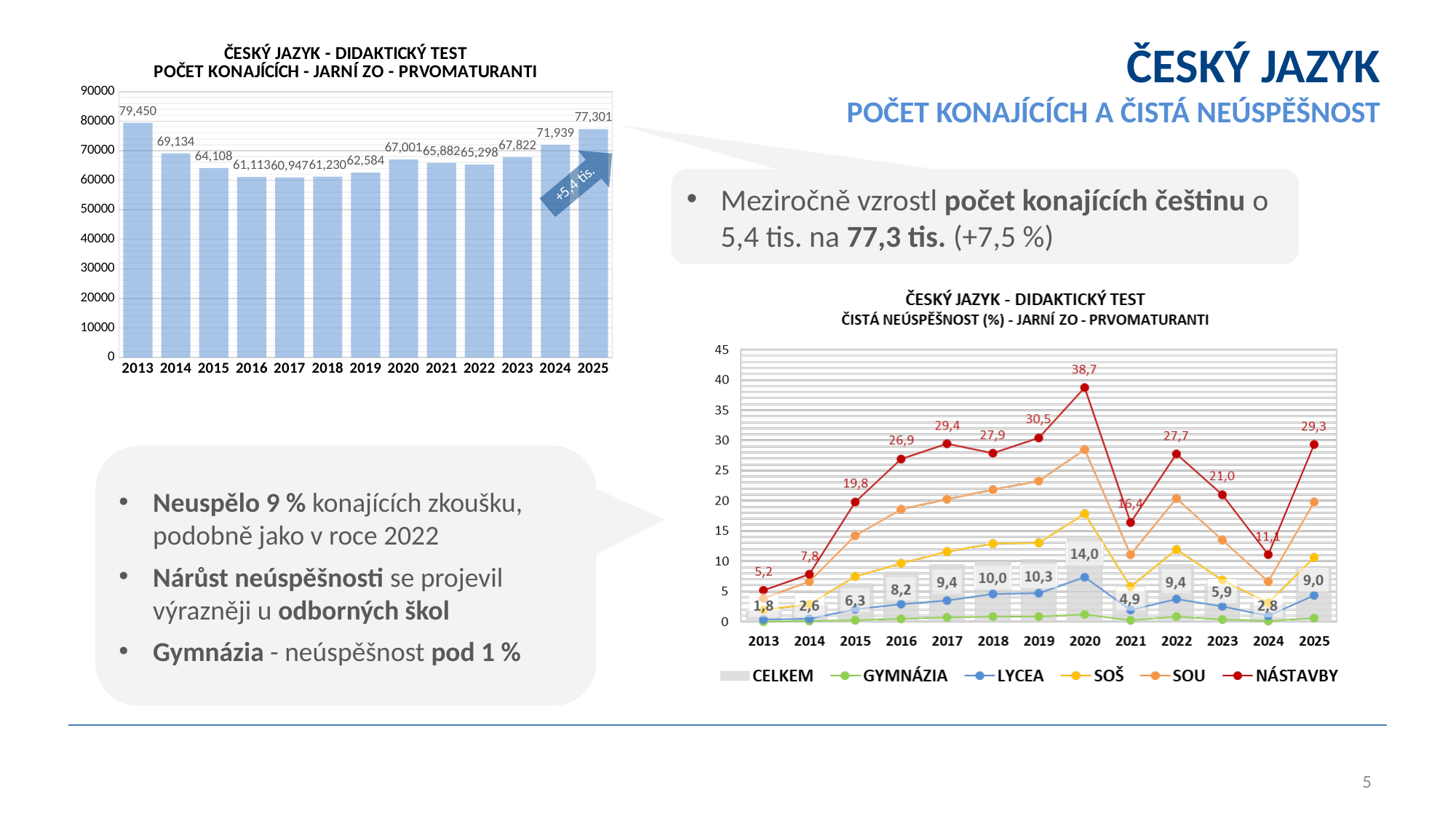
In the chart on the right (ČISTÁ NEÚSPĚŠNOST), how many series does the legend list? 6 In the chart on the right (ČISTÁ NEÚSPĚŠNOST), what is the value for NÁSTAVBY in 2020? 38,7 In the chart on the right (ČISTÁ NEÚSPĚŠNOST), which is larger in 2021: the NÁSTAVBY value or the CELKEM value? NÁSTAVBY In the chart on the right (ČISTÁ NEÚSPĚŠNOST), what is the CELKEM value for 2025? 9,0 In the bar chart on the left (POČET KONAJÍCÍCH), what is the value for 2025? 77,301 In the bar chart on the left (POČET KONAJÍCÍCH), which year has the highest value? 2013 In the bar chart on the left (POČET KONAJÍCÍCH), how many years are shown on the x axis? 13 In the bar chart on the left (POČET KONAJÍCÍCH), which year has the lowest value? 2017 In the chart on the right (ČISTÁ NEÚSPĚŠNOST), is the SOU value for 2020 greater or less than 25? greater In the bar chart on the left (POČET KONAJÍCÍCH), what is the difference between the values for 2025 and 2024? 5,362 What kind of chart is the chart on the left (POČET KONAJÍCÍCH)? bar chart In the chart on the right (ČISTÁ NEÚSPĚŠNOST), what is the difference between the NÁSTAVBY values for 2025 and 2024? 18,2